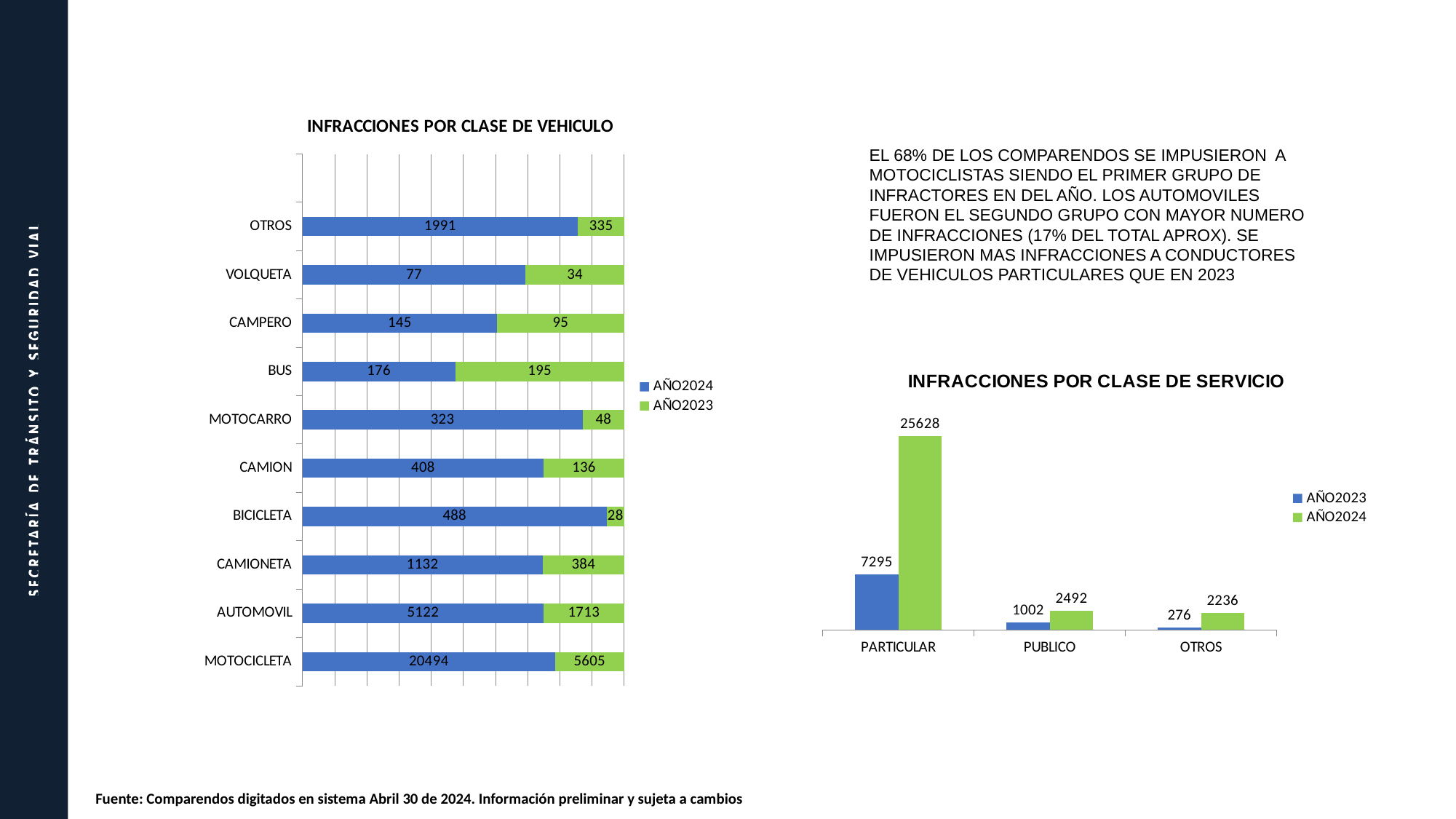
In the chart 'INFRACCIONES POR CLASE DE VEHICULO', what is the total of the two values for CAMION? 544 In the chart 'INFRACCIONES POR CLASE DE VEHICULO', what is the AÑO2024 value for MOTOCICLETA? 20494 In the chart 'INFRACCIONES POR CLASE DE VEHICULO', which is larger for BUS: the AÑO2024 value or the AÑO2023 value? AÑO2023 In the chart 'INFRACCIONES POR CLASE DE VEHICULO', which vehicle class has the highest AÑO2024 value? MOTOCICLETA In the chart 'INFRACCIONES POR CLASE DE VEHICULO', which vehicle class has the lowest AÑO2023 value? BICICLETA In the chart 'INFRACCIONES POR CLASE DE VEHICULO', what is the AÑO2023 value for AUTOMOVIL? 1713 In the chart 'INFRACCIONES POR CLASE DE SERVICIO', which category has the lowest AÑO2023 value? OTROS In the chart 'INFRACCIONES POR CLASE DE VEHICULO', what is the difference between the AÑO2024 and AÑO2023 values for CAMIONETA? 748 What kind of chart is 'INFRACCIONES POR CLASE DE SERVICIO'? Bar chart In the chart 'INFRACCIONES POR CLASE DE VEHICULO', how many vehicle classes are shown? 10 In the chart 'INFRACCIONES POR CLASE DE SERVICIO', what is the AÑO2024 value for PARTICULAR? 25628 In the chart 'INFRACCIONES POR CLASE DE SERVICIO', what is the difference between the AÑO2024 and AÑO2023 values for PUBLICO? 1490